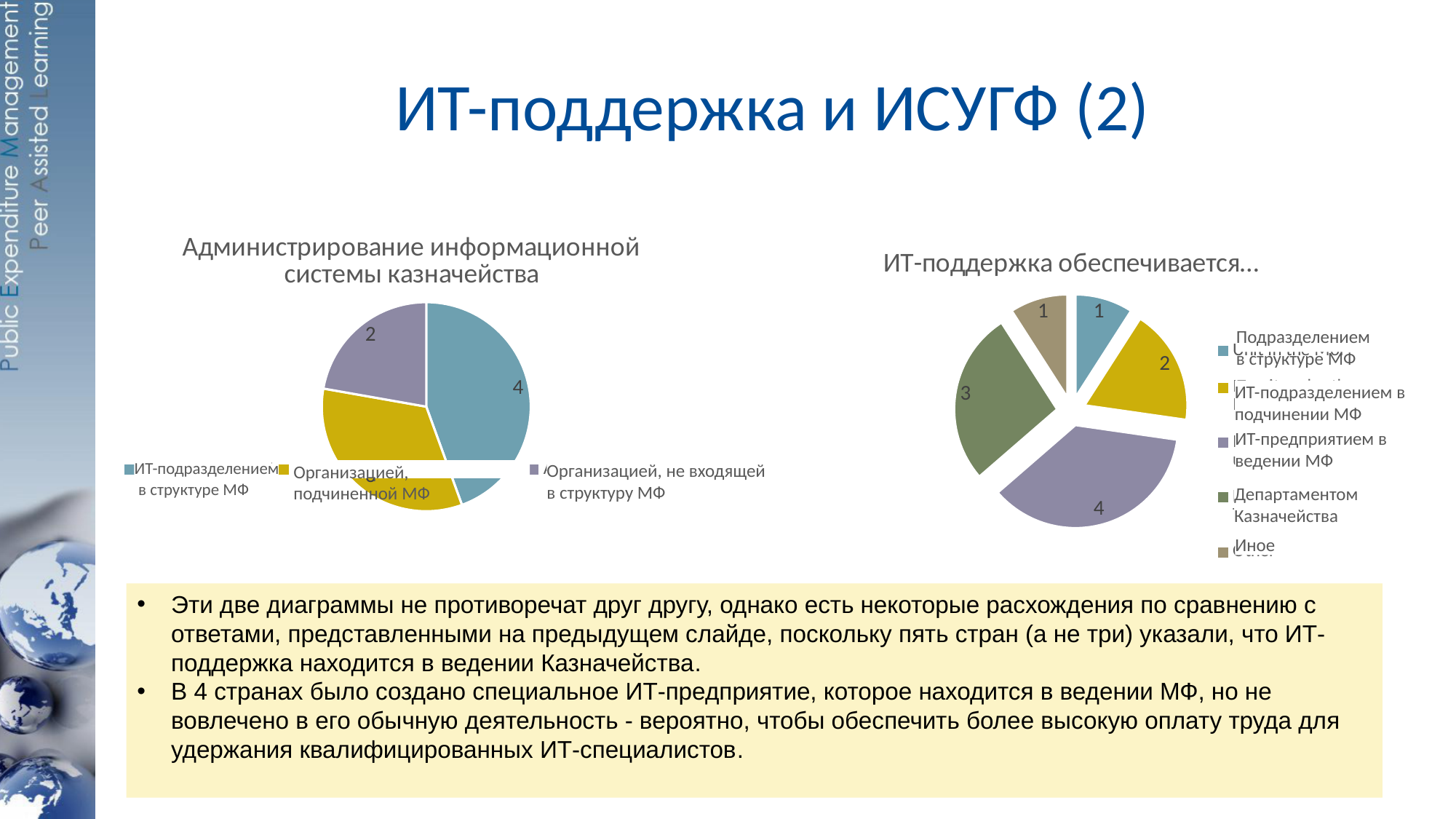
In the chart titled "ИТ-поддержка обеспечивается…", which category has the largest slice? ИТ-предприятием в ведении МФ In the chart titled "Администрирование информационной системы казначейства", which category has the largest slice? ИТ-подразделением в структуре МФ In the chart titled "Администрирование информационной системы казначейства", what is the value for "ИТ-подразделением в структуре МФ"? 4 In the chart titled "ИТ-поддержка обеспечивается…", what is the total of all slice values? 11 In the chart titled "ИТ-поддержка обеспечивается…", what is the difference between the values for "ИТ-предприятием в ведении МФ" and "ИТ-подразделением в подчинении МФ"? 2 In the chart titled "Администрирование информационной системы казначейства", how many categories does the legend list? 3 In the chart titled "ИТ-поддержка обеспечивается…", what is the value for "ИТ-предприятием в ведении МФ"? 4 In the chart titled "ИТ-поддержка обеспечивается…", how many slices does the pie have? 5 In the chart titled "ИТ-поддержка обеспечивается…", which is larger: "Департаментом Казначейства" or "ИТ-подразделением в подчинении МФ"? Департаментом Казначейства In the chart titled "ИТ-поддержка обеспечивается…", what is the value for "Департаментом Казначейства"? 3 What kind of chart is the one titled "Администрирование информационной системы казначейства"? Pie chart In the chart titled "Администрирование информационной системы казначейства", what is the value for "Организацией, не входящей в структуру МФ"? 2